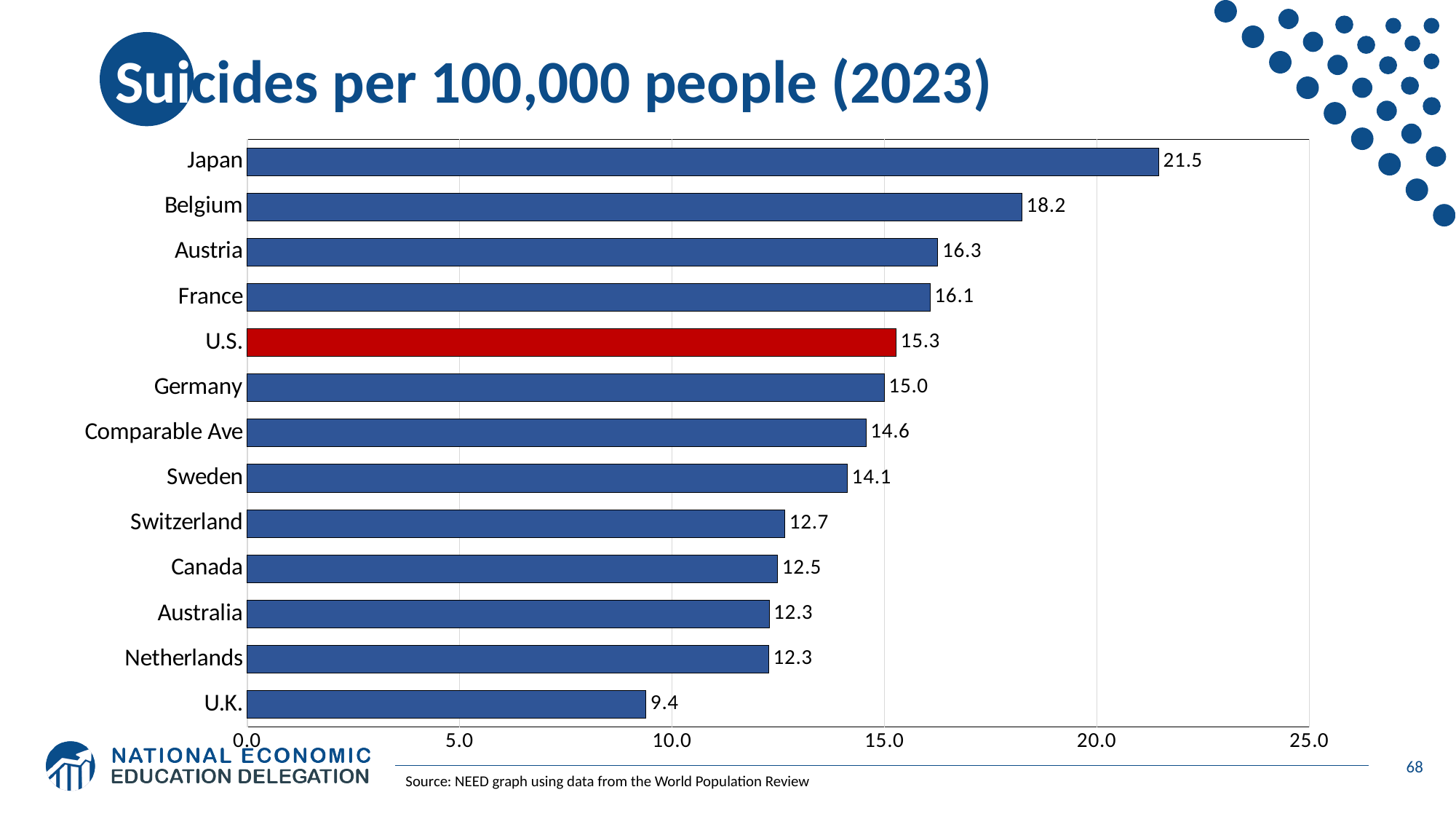
Which is larger, the value for Austria or the value for Sweden? Austria What is the difference between the values for the U.S. and the U.K.? 5.9 Is the value for Belgium greater or less than 15.0? greater Which category has the lowest value? U.K. How many categories are shown on the chart? 13 What is the value for the U.S.? 15.3 What is the difference between the values for Japan and Belgium? 3.3 Which category has the highest value? Japan What kind of chart is shown on the slide? Bar chart What is the value for Comparable Ave? 14.6 What is the value for Japan? 21.5 Which bar is coloured red rather than blue? U.S.